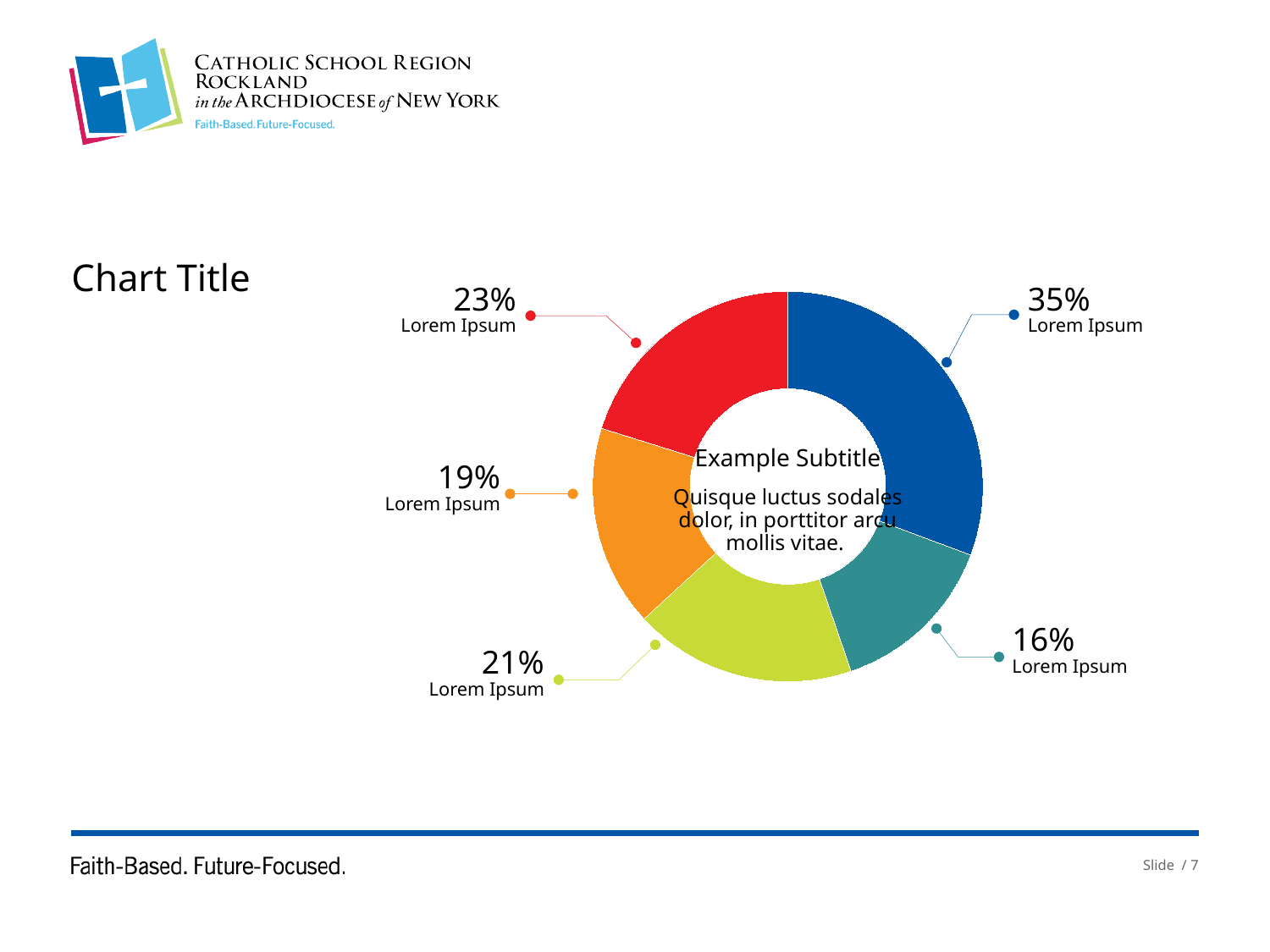
What subtitle text appears in the centre of the donut chart? Example Subtitle What kind of chart is shown on the slide? Pie chart (donut) What percentage is shown for the blue slice of the donut chart? 35% What percentage is shown for the red slice of the donut chart? 23% What is the difference between the largest slice (35%) and the smallest slice (16%)? 19 percentage points How many slices does the donut chart have? 5 What percentage is shown for the orange slice of the donut chart? 19% What percentage is shown for the teal slice of the donut chart? 16% What is the title of the chart? Chart Title Which is larger, the red slice or the green slice? The red slice (23%) Which slice of the donut chart has the largest share? The blue slice (35%) Which slice of the donut chart has the smallest share? The teal slice (16%)